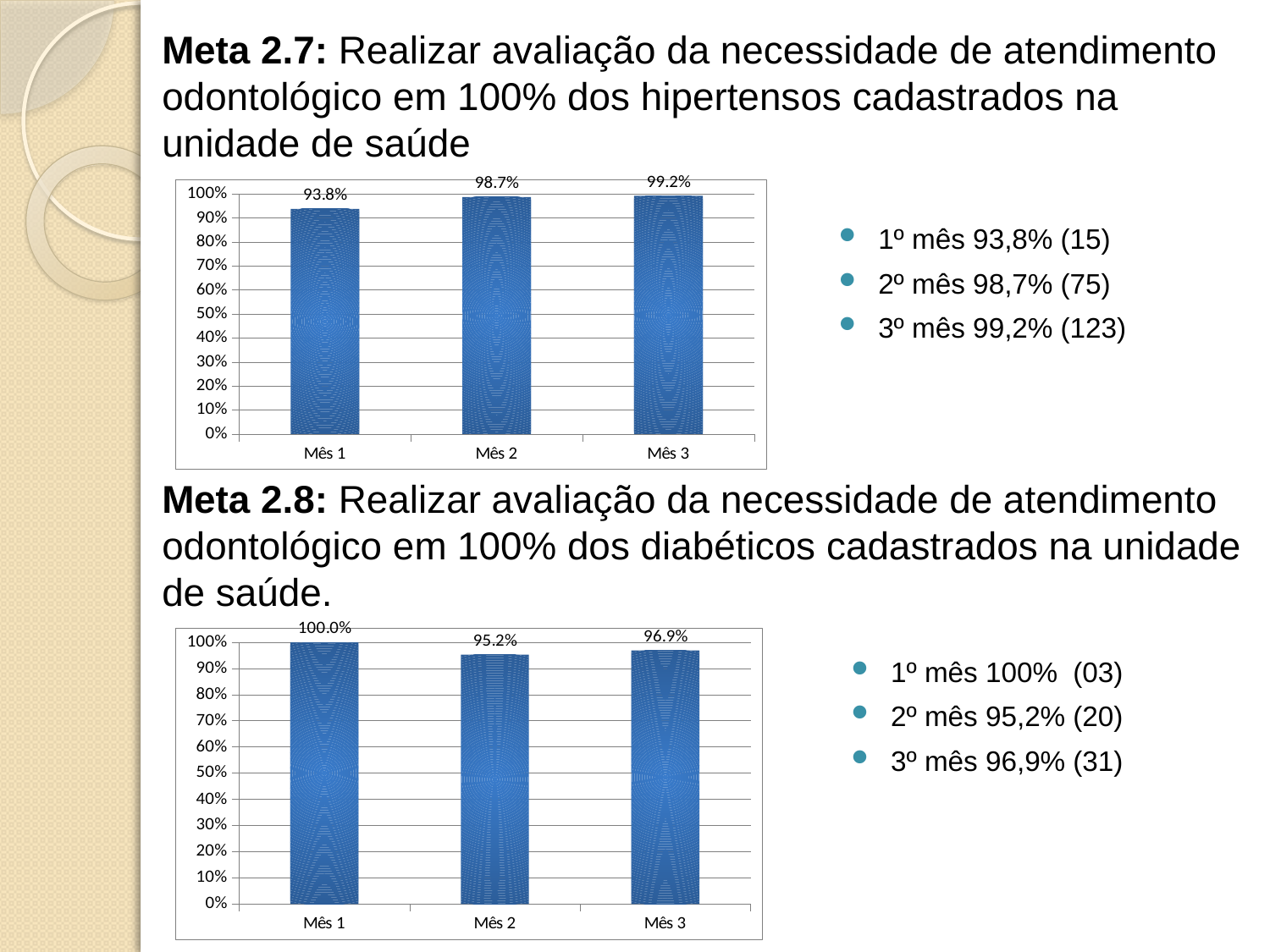
In the top chart (Meta 2.7), what is the value for Mês 1? 93.8% In the bottom chart (Meta 2.8), which month has the lowest value? Mês 2 In the bottom chart (Meta 2.8), what is the difference between the values for Mês 1 and Mês 2? 4.8 percentage points In the top chart (Meta 2.7), what is the value for Mês 3? 99.2% In the bottom chart (Meta 2.8), what is the value for Mês 2? 95.2% In the top chart (Meta 2.7), which month has the lowest value? Mês 1 In the bottom chart (Meta 2.8), which month has the highest value? Mês 1 How many categories are shown on the x axis of the top chart (Meta 2.7)? 3 In the top chart (Meta 2.7), do the values rise or fall from Mês 1 to Mês 3? rise What kind of chart is the bottom chart (Meta 2.8)? bar chart In the bottom chart (Meta 2.8), what is the value for Mês 3? 96.9% In the top chart (Meta 2.7), what is the difference between the values for Mês 3 and Mês 1? 5.4 percentage points